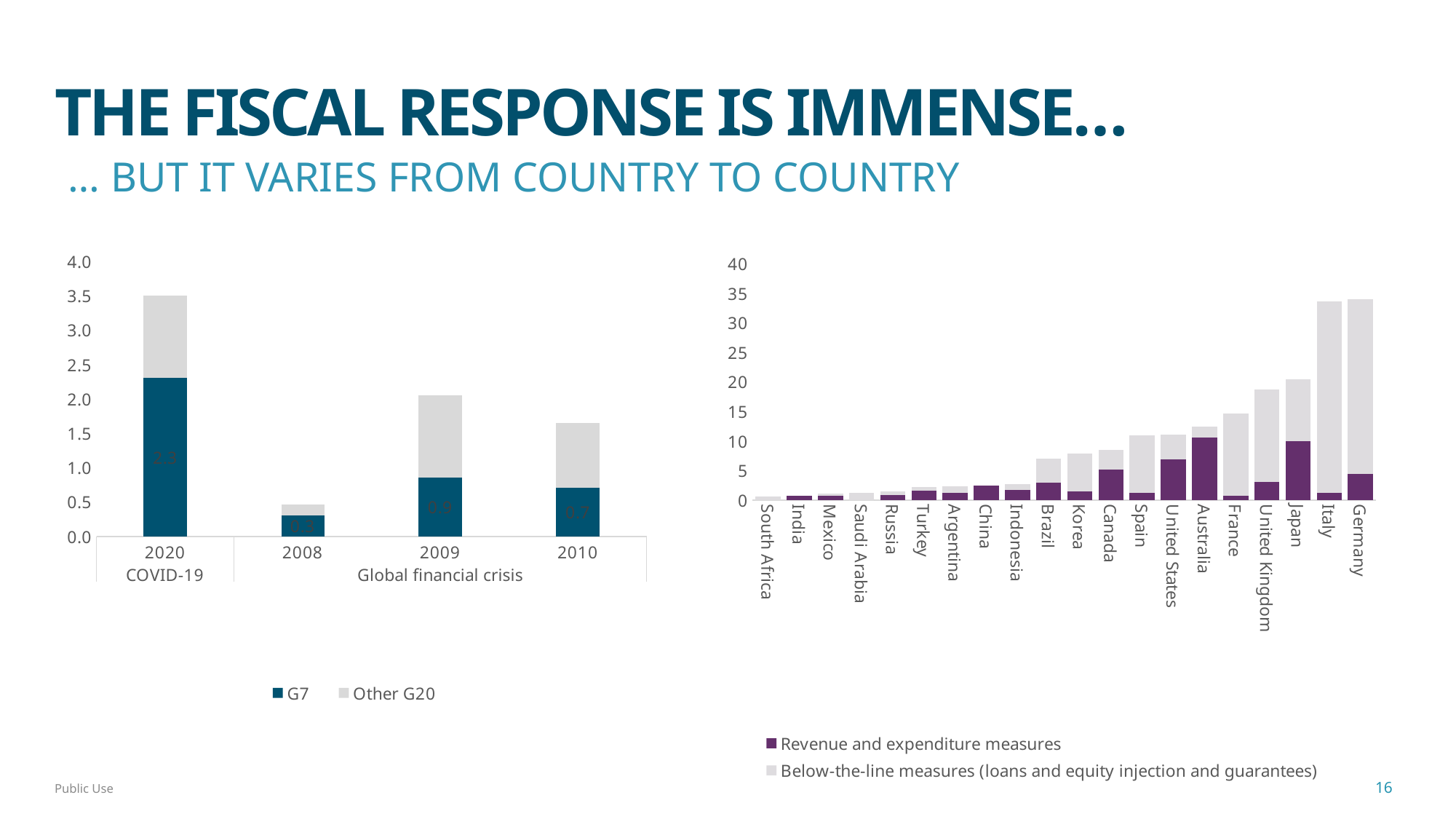
On the left chart, how many series does the legend list? 2 On the left chart, which is larger, the G7 value for 2009 or for 2010? 2009 On the left chart, is the total stacked value for 2020 greater or less than 3.0? greater On the right chart, how many countries are shown on the x axis? 20 On the left chart, which year has the highest total stacked bar? 2020 On the left chart, what is the G7 value for 2020? 2.3 What kind of chart is the right chart? Stacked bar chart On the right chart, which country has the lowest total stacked bar? South Africa On the left chart, what is the difference between the G7 value for 2020 and the G7 value for 2008? 2.0 On the left chart, which year has the lowest total stacked bar? 2008 On the left chart, what is the G7 value for 2009? 0.9 On the right chart, is the total stacked value for Italy greater or less than 30? greater